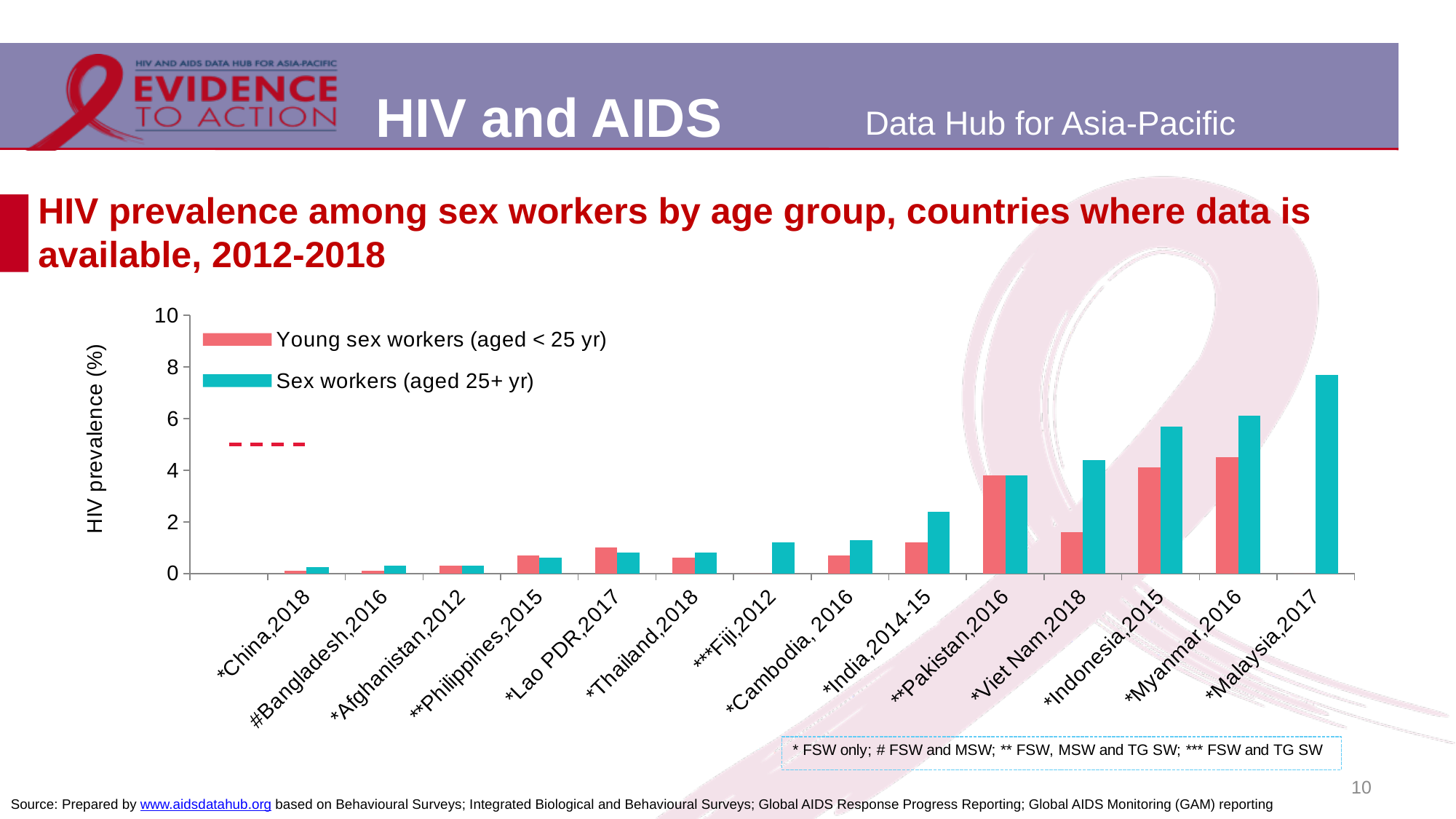
Is the value for sex workers aged 25+ yr in *Malaysia,2017 greater or less than 6? greater In *Viet Nam,2018, which series has the larger value: young sex workers (aged < 25 yr) or sex workers (aged 25+ yr)? Sex workers (aged 25+ yr) Which category has the highest value for sex workers aged 25+ yr? *Malaysia,2017 Which category has the lowest value for sex workers aged 25+ yr? *China,2018 Which category has the highest value for young sex workers (aged < 25 yr)? *Myanmar,2016 Is the value for sex workers aged 25+ yr in *India,2014-15 greater or less than 2? greater What kind of chart is shown on the slide? bar chart Is the value for sex workers aged 25+ yr in *Viet Nam,2018 greater or less than 4? greater How many series does the chart legend list? 2 How many country-year categories are shown on the x axis? 14 Do the values for sex workers aged 25+ yr generally rise or fall from left to right along the x axis? rise